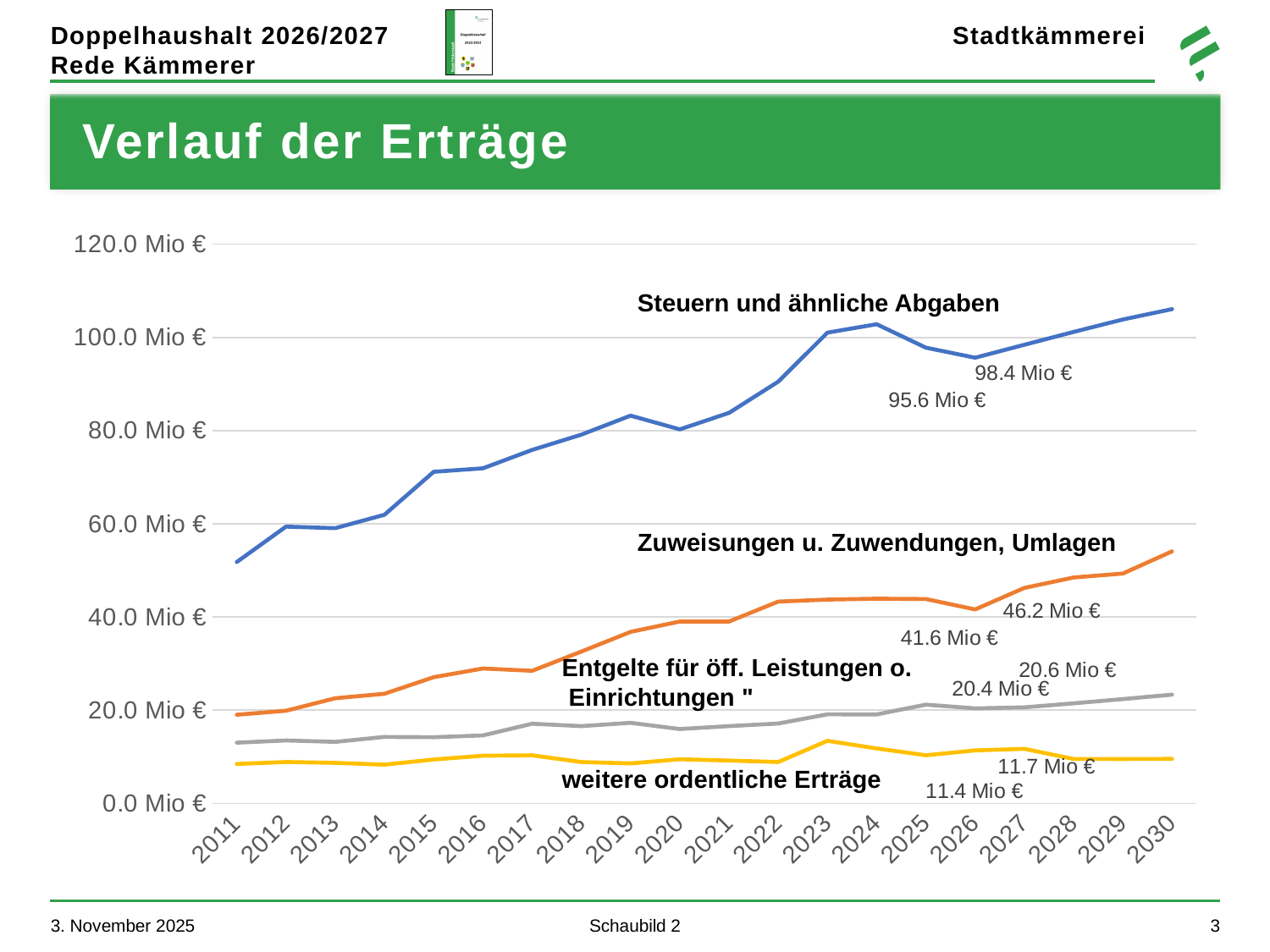
How many data series (lines) are plotted in the chart? 4 What is the difference between the two labelled values for Zuweisungen u. Zuwendungen, Umlagen (46.2 Mio € and 41.6 Mio €)? 4.6 Mio € Which series has the lowest values throughout the chart? weitere ordentliche Erträge What is the difference between the two labelled values for weitere ordentliche Erträge (11.7 Mio € and 11.4 Mio €)? 0.3 Mio € Is the value for Steuern und ähnliche Abgaben in 2030 greater or less than 100.0 Mio €? greater Which series has the highest values throughout the chart? Steuern und ähnliche Abgaben Is the value for Steuern und ähnliche Abgaben in 2011 greater or less than 60.0 Mio €? less What are the two values labelled on the line for Steuern und ähnliche Abgaben? 95.6 Mio € and 98.4 Mio € What are the two values labelled on the line for Zuweisungen u. Zuwendungen, Umlagen? 41.6 Mio € and 46.2 Mio € How many years are shown on the x axis of the chart? 20 What kind of chart is shown on the slide? line chart Does the line for Steuern und ähnliche Abgaben generally rise or fall from 2011 to 2030? rise